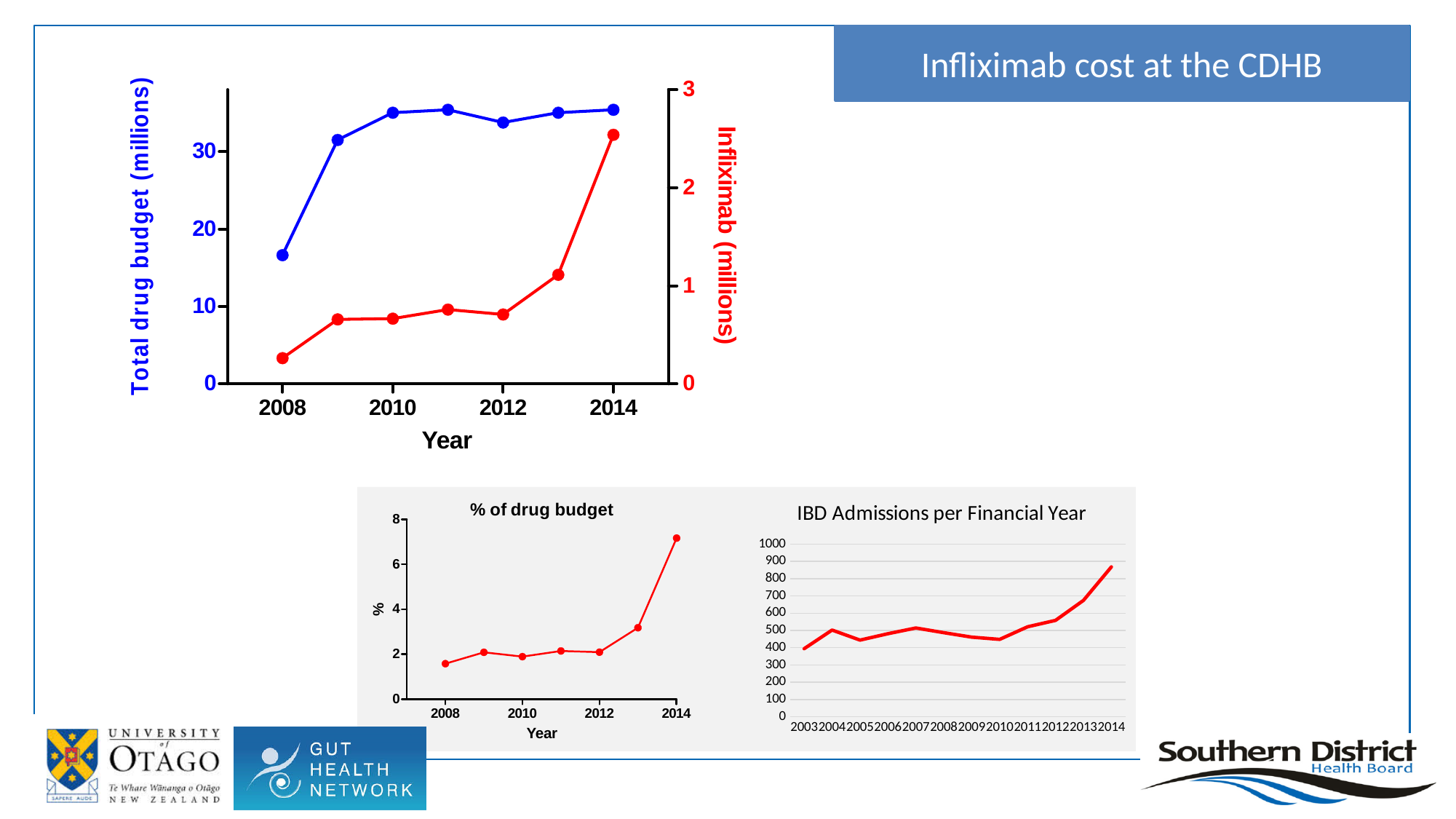
In the '% of drug budget' chart, do the values rise or fall from 2012 to 2014? rise In the top-left chart, what is the label of the right-hand (red) y axis? Infliximab (millions) In the 'IBD Admissions per Financial Year' chart, how many years are shown on the x axis? 12 In the '% of drug budget' chart, which year has the highest value? 2014 In the 'IBD Admissions per Financial Year' chart, is the value for 2014 greater or less than 800? greater In the top-left chart, is the Infliximab value for 2014 greater or less than 2 (millions)? greater What kind of chart is the top-left chart with the blue and red lines? line chart In the '% of drug budget' chart, is the value for 2014 greater or less than 6? greater In the top-left chart, how many years are plotted on the x axis? 7 In the top-left chart, which year has the lowest Infliximab value? 2008